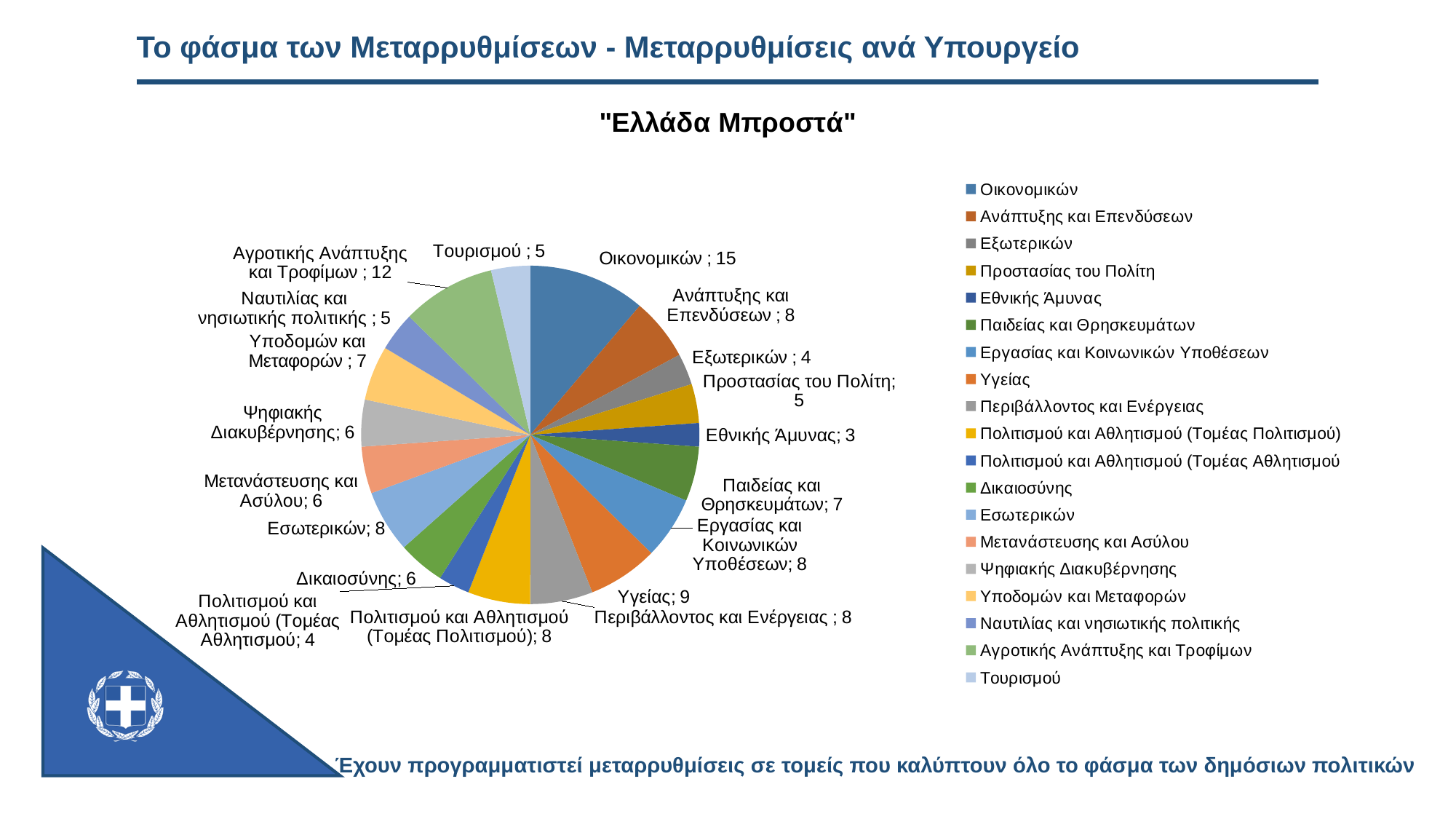
What is the difference between the values for Οικονομικών and Αγροτικής Ανάπτυξης και Τροφίμων? 3 What is the value for Οικονομικών? 15 What is the value for Υγείας? 9 What is the value for Αγροτικής Ανάπτυξης και Τροφίμων? 12 Which is larger, the value for Υγείας or the value for Υποδομών και Μεταφορών? Υγείας Which category has the largest slice of the pie? Οικονομικών Which category has the smallest slice of the pie? Εθνικής Άμυνας How many slices does the pie chart have? 19 What is the title of the pie chart? "Ελλάδα Μπροστά" What type of chart is shown on the slide? pie chart How many entries does the legend list? 19 What is the value for Εθνικής Άμυνας? 3